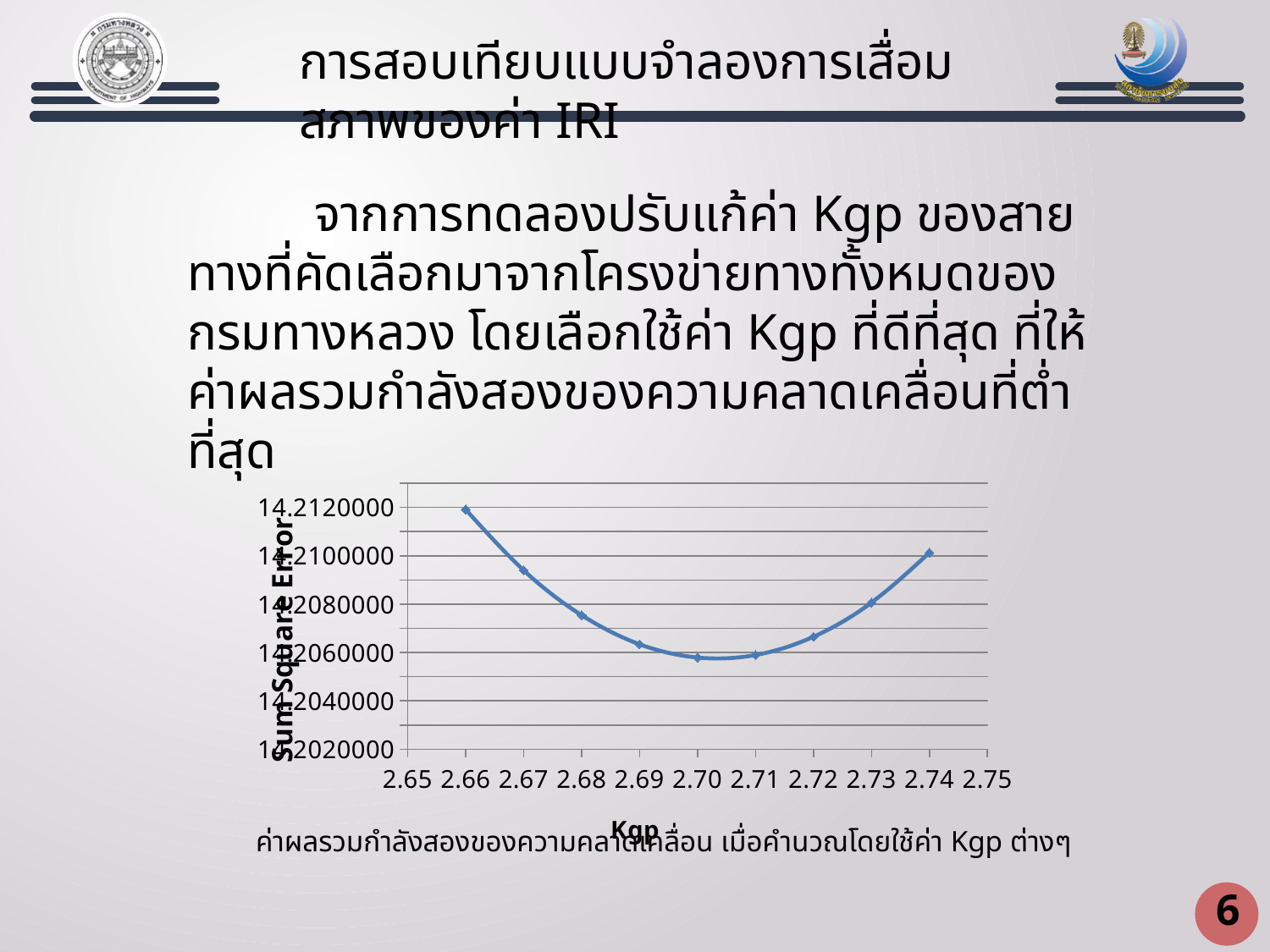
Is the Sum Square Error at Kgp 2.73 greater or less than 14.2100000? less Which has the larger Sum Square Error, Kgp 2.67 or Kgp 2.73? 2.67 At which Kgp value is the Sum Square Error highest? 2.66 What is the title of the y axis of the chart? Sum Square Error Which has the larger Sum Square Error, Kgp 2.66 or Kgp 2.74? 2.66 What is the title of the x axis of the chart? Kgp How many data points are plotted on the chart? 9 Is the Sum Square Error at Kgp 2.68 greater or less than 14.2060000? greater How does the Sum Square Error change as Kgp increases from 2.66 to 2.74? It falls, then rises What kind of chart is shown on the slide? line chart Is the Sum Square Error at Kgp 2.66 greater or less than 14.2100000? greater